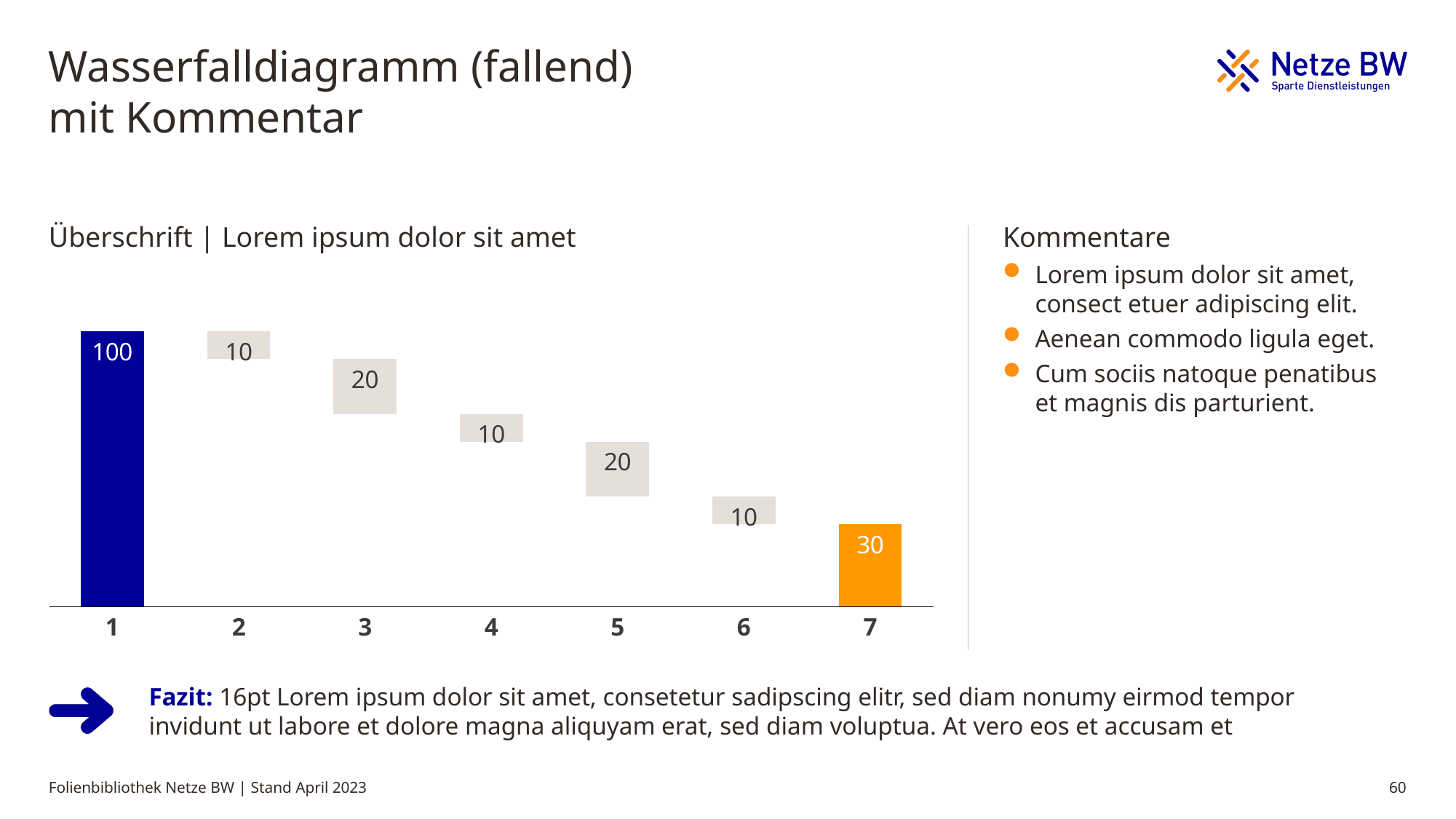
What is the difference between the values for category 1 and category 7? 70 Which has the larger value, category 2 or category 3? 3 Which category has the highest value? 1 What is the title shown above the chart? Überschrift | Lorem ipsum dolor sit amet What is the sum of the values for categories 2 through 6? 70 What is the value shown for category 6? 10 What is the value shown for category 3? 20 What is the value shown for category 1? 100 What is the value shown for category 7? 30 How many categories are shown on the x axis? 7 What kind of chart is shown on the slide? waterfall chart Which has the larger value, category 5 or category 7? 7